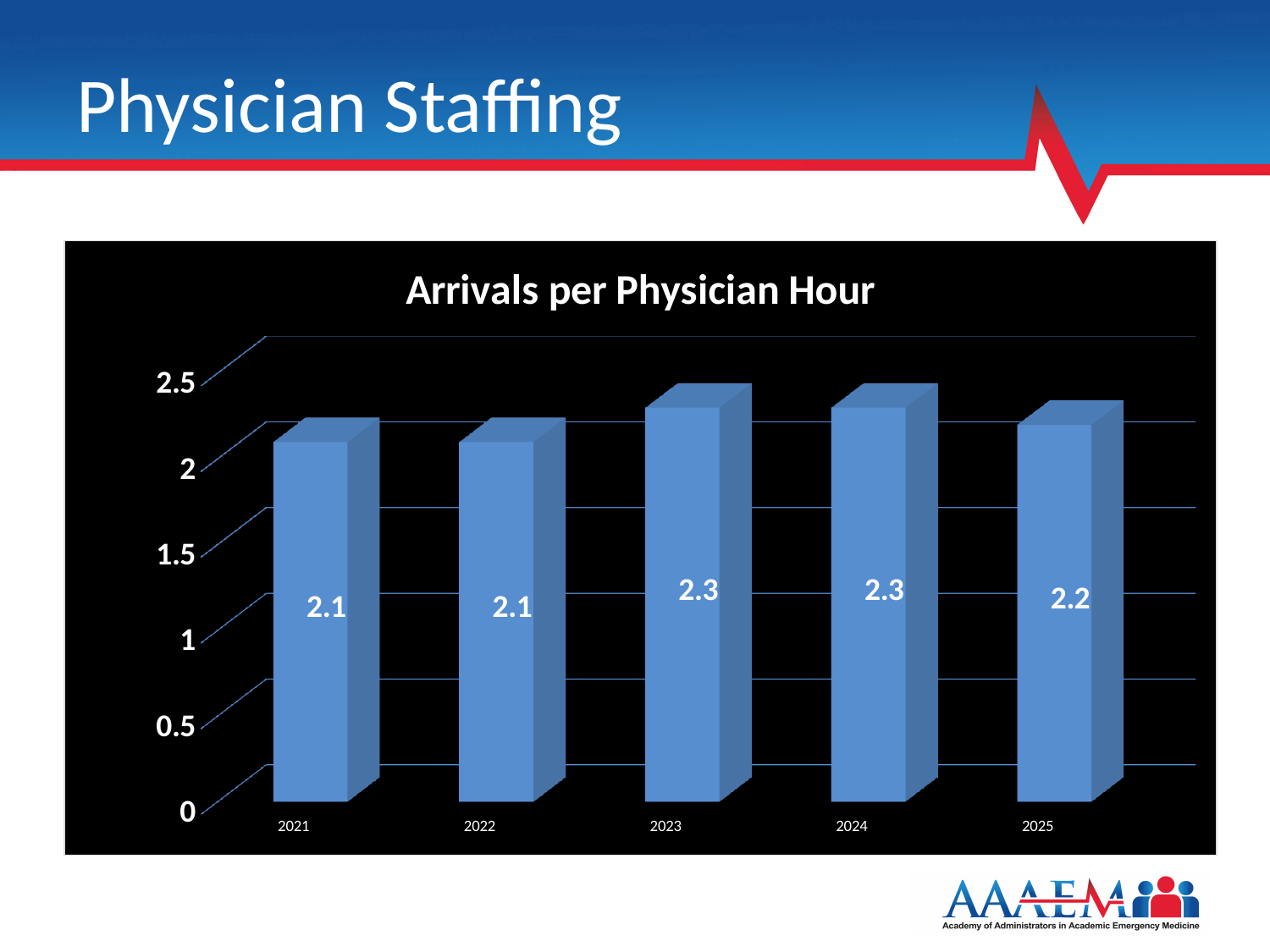
How many years are shown on the x axis? 5 Which year has the lowest value, 2022 or 2025? 2022 Is the value for 2024 greater or less than 2? greater What kind of chart is shown? bar chart What is the difference between the values for 2024 and 2025? 0.1 What is the value for 2023? 2.3 What is the title of the chart? Arrivals per Physician Hour What is the difference between the values for 2023 and 2021? 0.2 What is the value for 2021? 2.1 Does the value rise or fall from 2022 to 2023? rise Is the value for 2022 greater or less than 2.5? less What is the value for 2025? 2.2